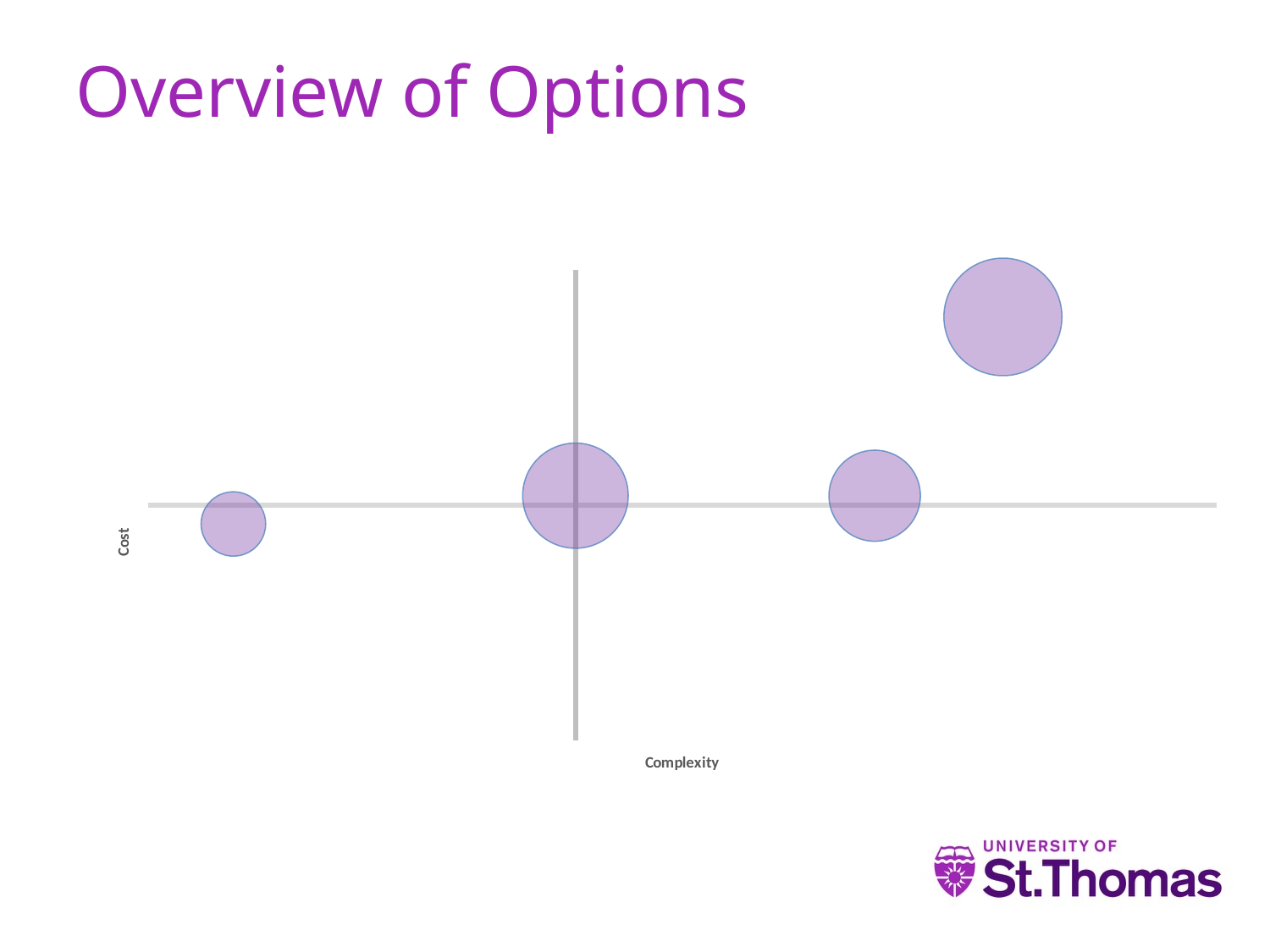
How many bubbles are plotted on the chart? 4 How many bubbles lie clearly above the horizontal axis line? 1 What is the title of the horizontal axis of the chart? Complexity Which bubble has the higher cost: the leftmost bubble or the rightmost bubble? the rightmost bubble What kind of chart is shown on the slide? bubble chart What is the title of the vertical axis of the chart? Cost